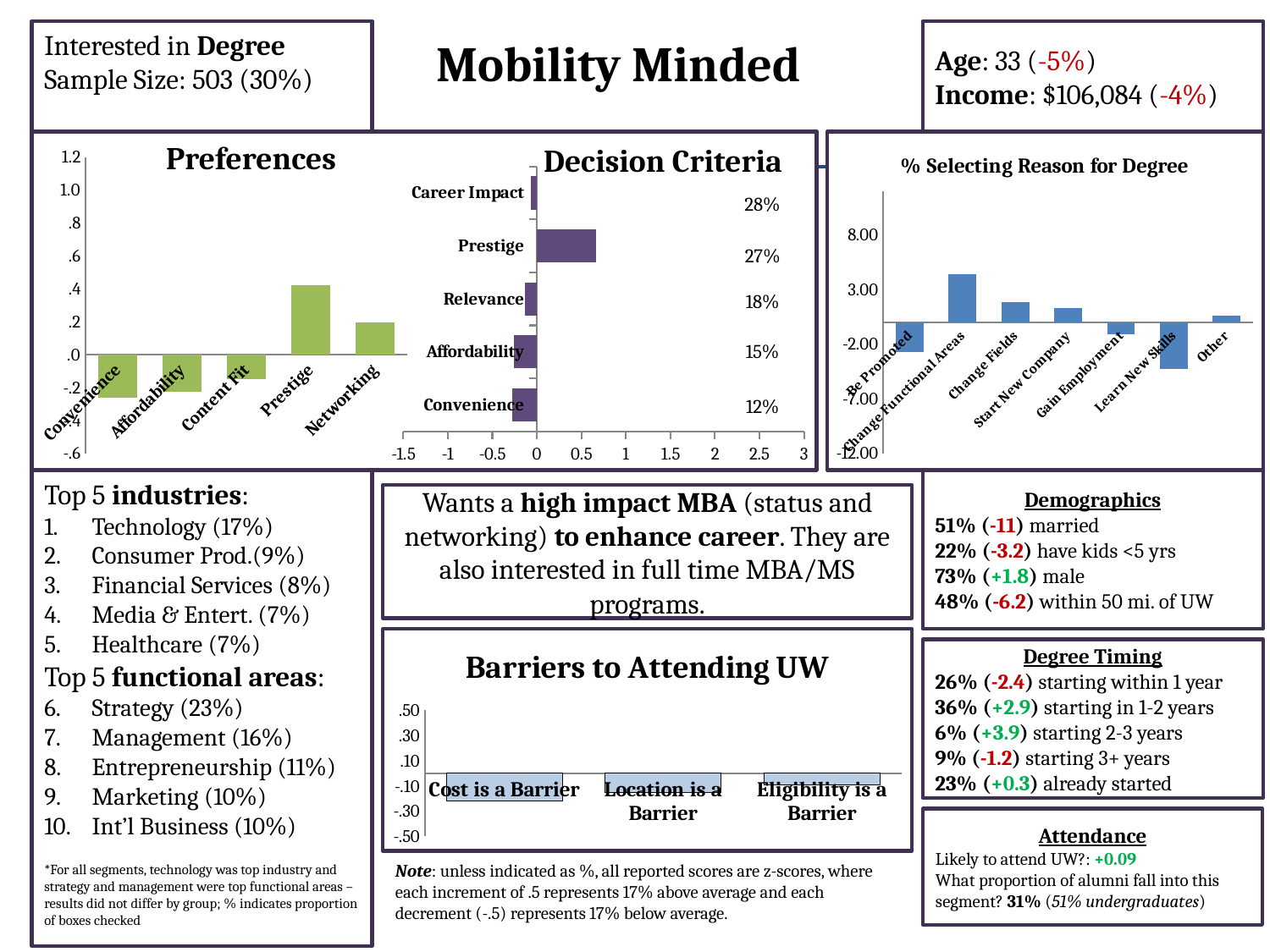
In the Preferences chart, which category has the highest value? Prestige How many categories are shown in the Preferences chart? 5 How many categories are shown in the % Selecting Reason for Degree chart? 7 In the Decision Criteria chart, what percentage is shown for Convenience? 12% In the Decision Criteria chart, what percentage is shown for Career Impact? 28% In the % Selecting Reason for Degree chart, which category has the highest value? Change Functional Areas In the Preferences chart, which is larger, Prestige or Networking? Prestige In the Preferences chart, is the value for Prestige greater or less than .2? greater What kind of chart is the Barriers to Attending UW chart? bar chart In the Decision Criteria chart, which category has the longest bar (highest z-score)? Prestige In the Decision Criteria chart, is the z-score for Prestige greater or less than 0.5? greater In the % Selecting Reason for Degree chart, which category has the lowest value? Learn New Skills